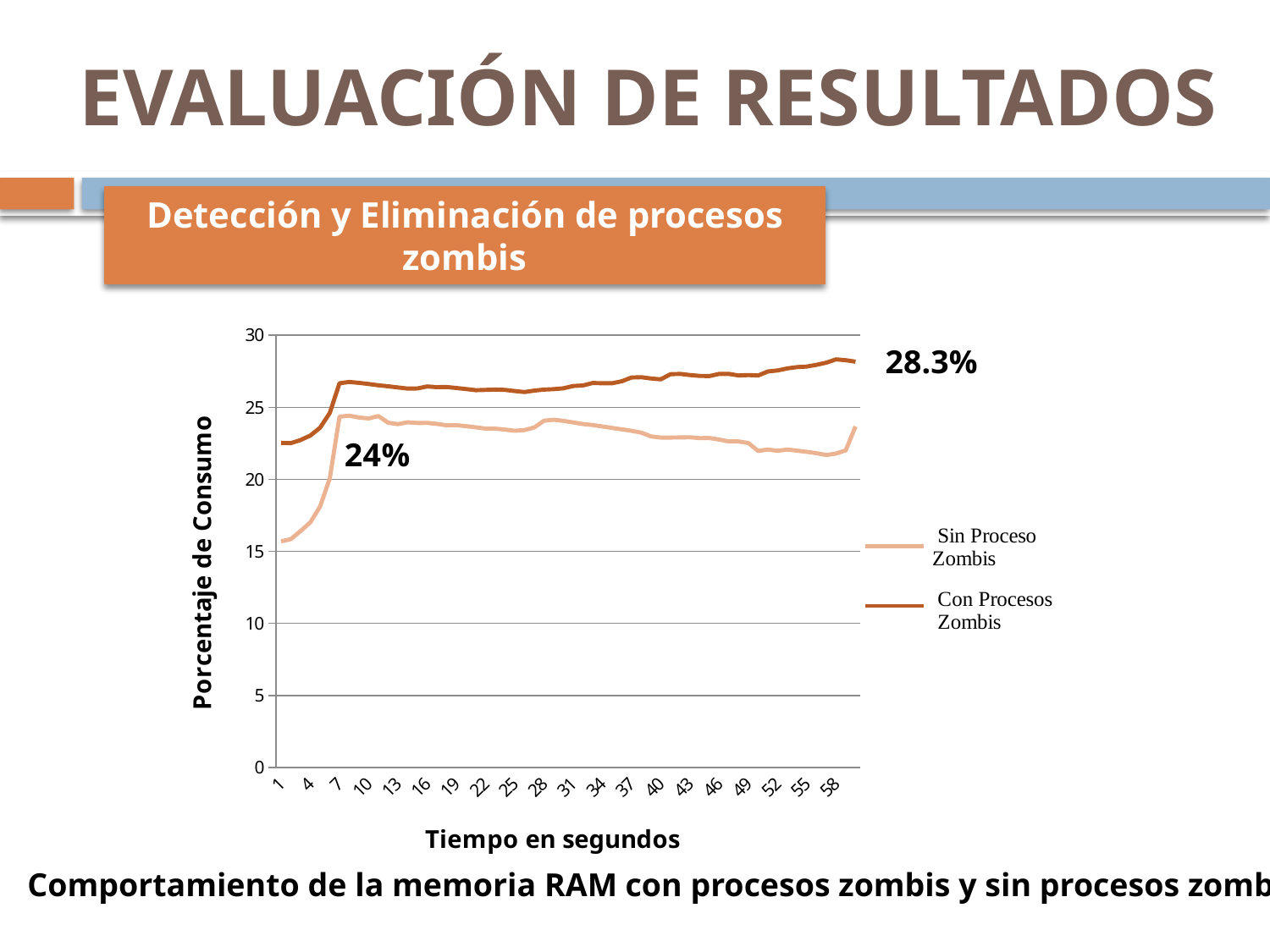
Is the value for Con Procesos Zombis at second 58 greater or less than 25? greater What are the two series named in the chart legend? Sin Proceso Zombis and Con Procesos Zombis What kind of chart is shown on the slide? Line chart What value is annotated at the end of the Con Procesos Zombis line? 28.3% Between second 10 and second 58, does the Con Procesos Zombis line generally rise or fall? rise At second 40, which series has the higher value, Sin Proceso Zombis or Con Procesos Zombis? Con Procesos Zombis What value is annotated next to the Sin Proceso Zombis line after its initial rise? 24% Is the value for Sin Proceso Zombis at second 1 greater or less than 20? less Between second 10 and second 55, does the Sin Proceso Zombis line generally rise or fall? fall What is the title of the vertical axis of the chart? Porcentaje de Consumo How many series does the chart legend list? 2 Is the value for Sin Proceso Zombis at second 49 greater or less than 25? less